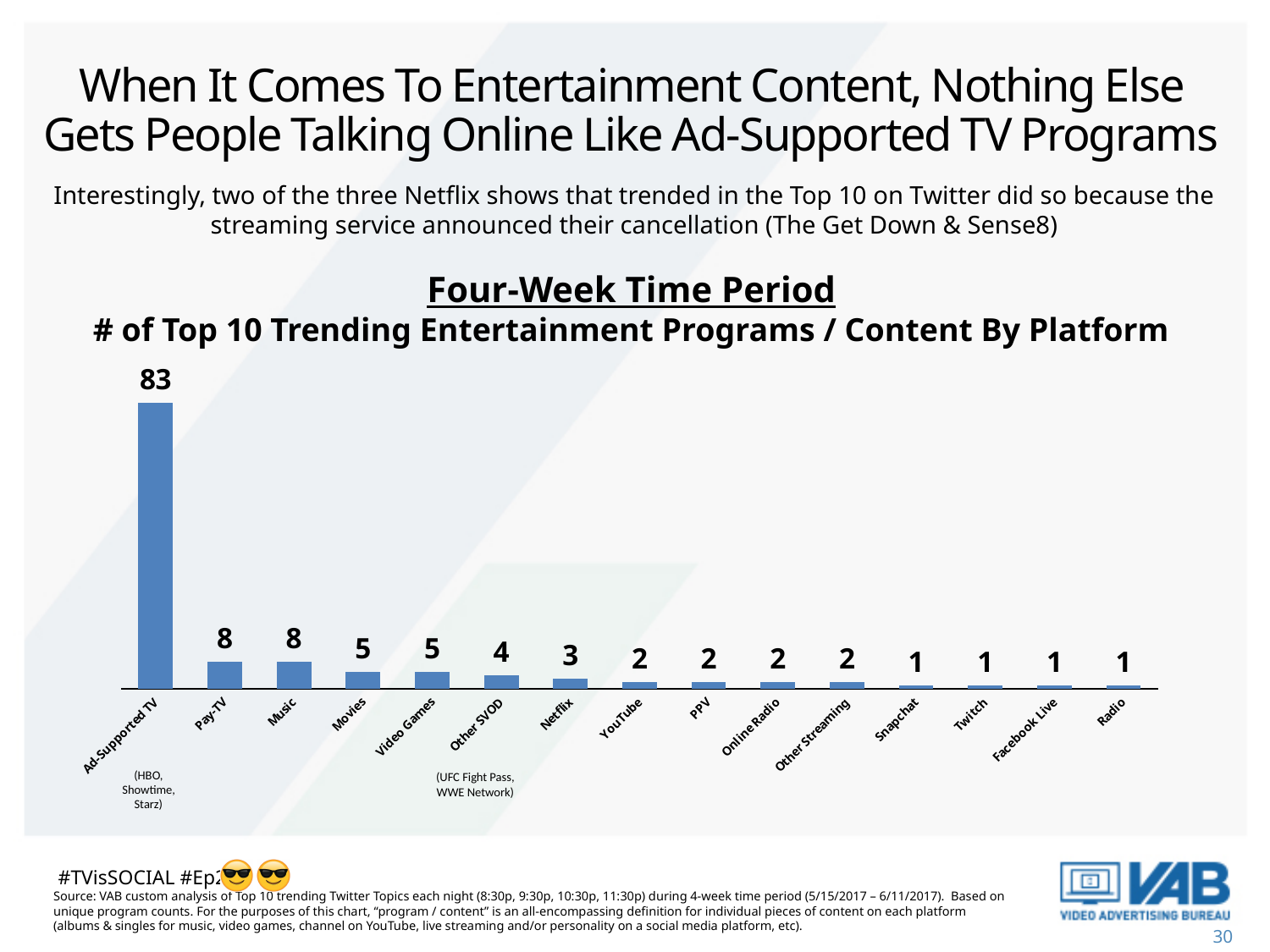
Which is larger, the value for Video Games or the value for YouTube? Video Games What is the value for Movies? 5 What is the difference between the values for Music and Netflix? 5 What is the value for Other SVOD? 4 What is the value for Ad-Supported TV? 83 Which platform has the highest number of Top 10 trending entertainment programs? Ad-Supported TV What kind of chart is shown on the slide? Bar chart How many platforms are shown on the x axis of the chart? 15 What is the difference between the values for Ad-Supported TV and Pay-TV? 75 Which platforms are listed in parentheses under the Pay-TV bar? HBO, Showtime, Starz Do the values generally rise or fall moving from left to right along the x axis? Fall What is the value for Netflix? 3